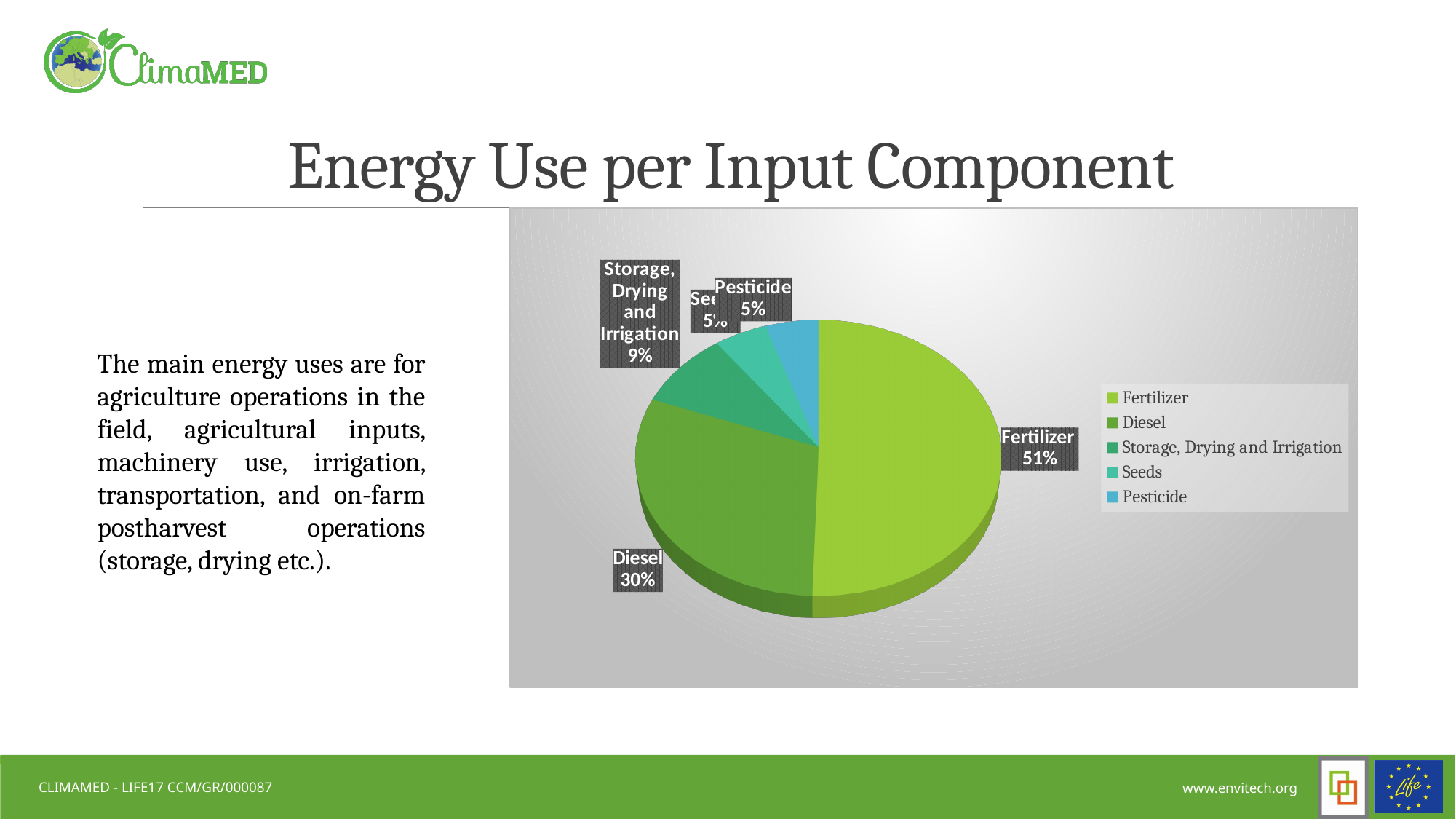
How many percentage points larger is the Fertilizer share than the Diesel share? 21% Which input component has the largest share of energy use? Fertilizer What kind of chart is shown on the slide? pie chart What share of energy use does Diesel account for? 30% Which has a larger share, Diesel or Storage, Drying and Irrigation? Diesel What share of energy use does Pesticide account for? 5% How many slices does the pie chart have? 5 What share of energy use does Fertilizer account for? 51% What is the title of the slide containing the pie chart? Energy Use per Input Component How many entries does the legend list? 5 How many percentage points larger is the Diesel share than the Pesticide share? 25% What share of energy use does Storage, Drying and Irrigation account for? 9%